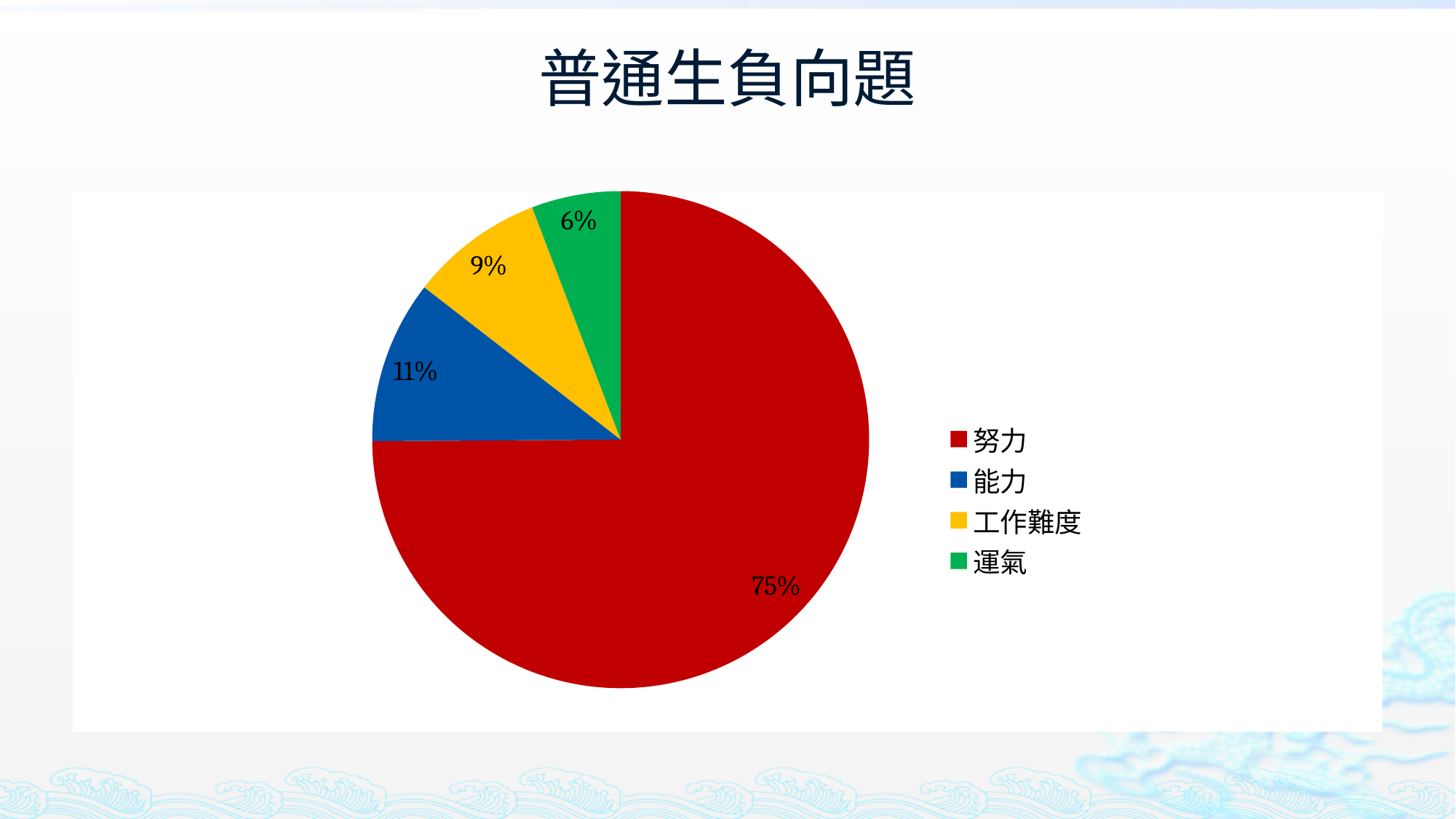
What kind of chart is shown on the slide? pie chart What share of the pie does 能力 take? 11% What share of the pie does 運氣 take? 6% What share of the pie does 工作難度 take? 9% How many slices does the pie chart have? 4 What is the difference in percentage points between 努力 and 能力? 64 What is the title of the slide containing the pie chart? 普通生負向題 Which is larger, the slice for 工作難度 or the slice for 運氣? 工作難度 Which category has the smallest slice of the pie? 運氣 What colour is the slice for 能力? blue Which category has the largest slice of the pie? 努力